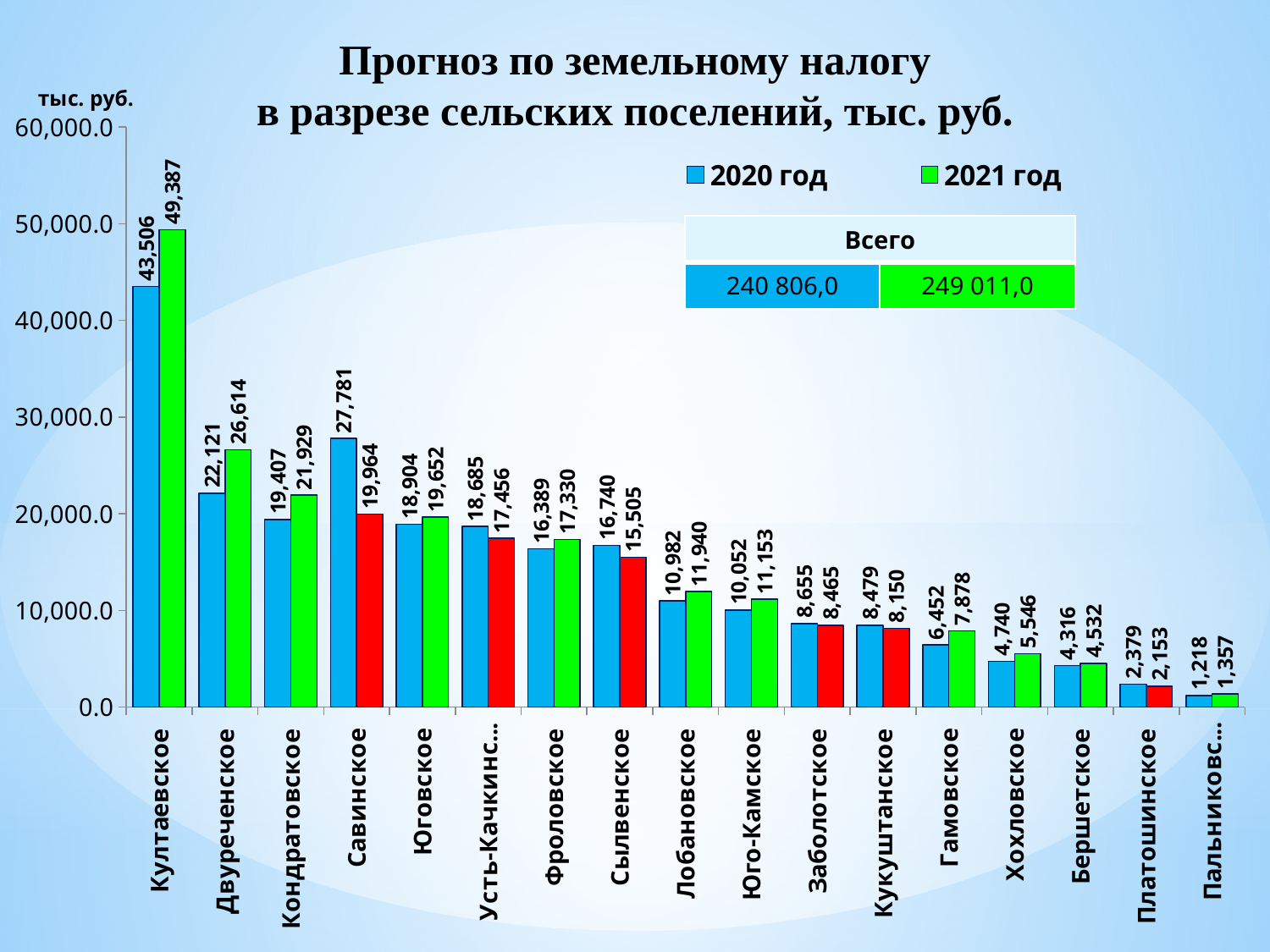
What is the total (Всего) shown for 2021 год? 249 011,0 How many settlements are shown on the x axis? 17 What is the 2020 год value for Двуреченское? 22,121 What kind of chart is shown on the slide? bar chart Which is larger for Савинское, the 2020 год value or the 2021 год value? 2020 год Which settlement has the highest 2021 год value? Култаевское What is the difference between the 2021 год and 2020 год values for Култаевское? 5,881 Is the 2020 год value for Кондратовское greater or less than 20,000.0? less Which settlement has the lowest 2020 год value? Пальниковс... What is the 2021 год value for Савинское? 19,964 What is the 2021 год value for Гамовское? 7,878 How many series does the legend list? 2